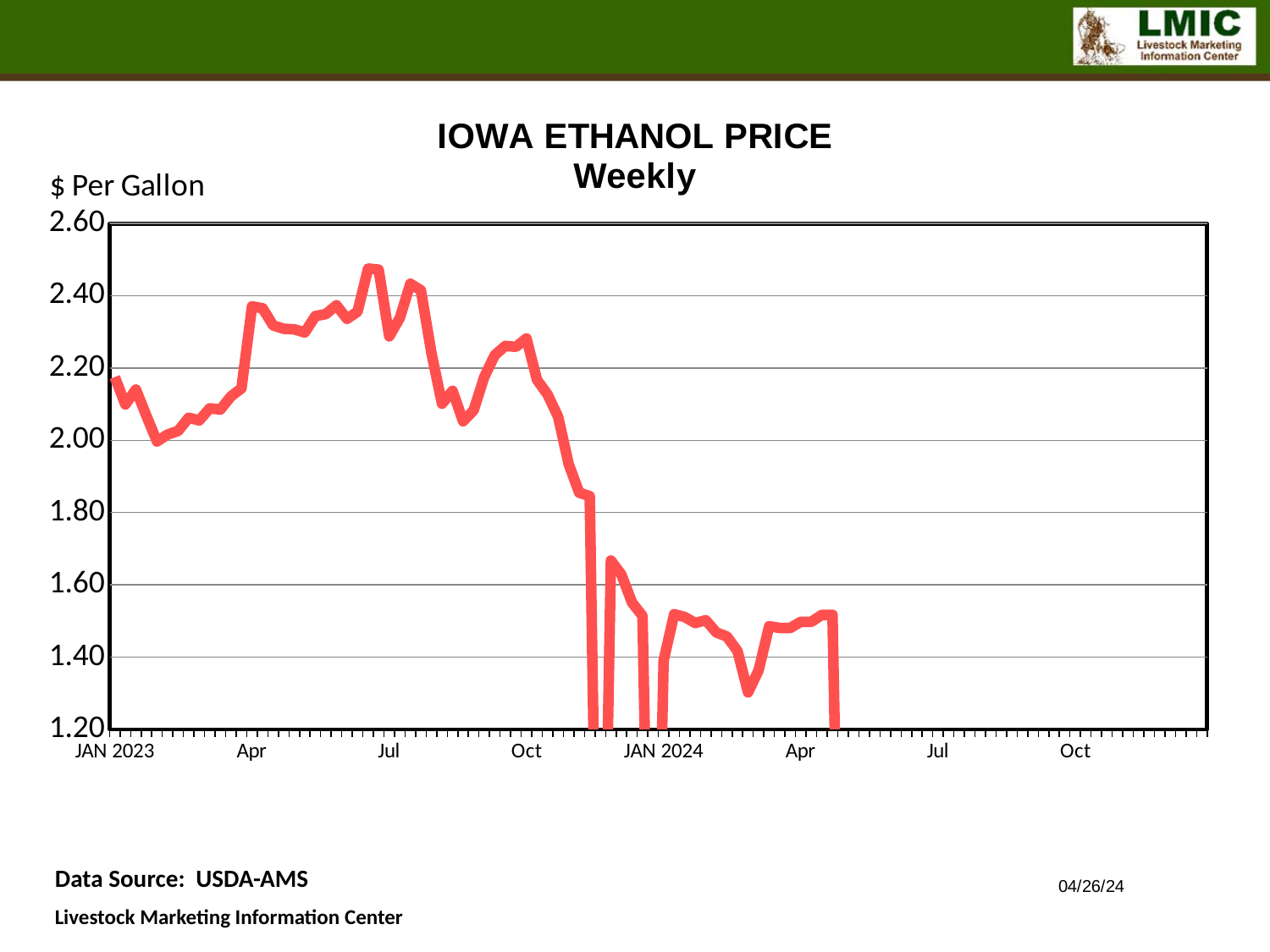
What kind of chart is shown on the slide? line chart What unit is shown on the y axis of the chart? $ Per Gallon Is the ethanol price at JAN 2024 greater or less than 1.80? less Is the ethanol price at JAN 2023 greater or less than 2.00? greater Is the highest ethanol price reached in mid-2023 greater or less than 2.40? greater Overall, does the ethanol price rise or fall from JAN 2023 to Apr 2024? fall What is the title of the chart? IOWA ETHANOL PRICE Weekly What is the lowest value shown on the y axis of the chart? 1.20 What is the highest value shown on the y axis of the chart? 2.60 Which is higher, the ethanol price at Apr 2023 or at Apr 2024? Apr 2023